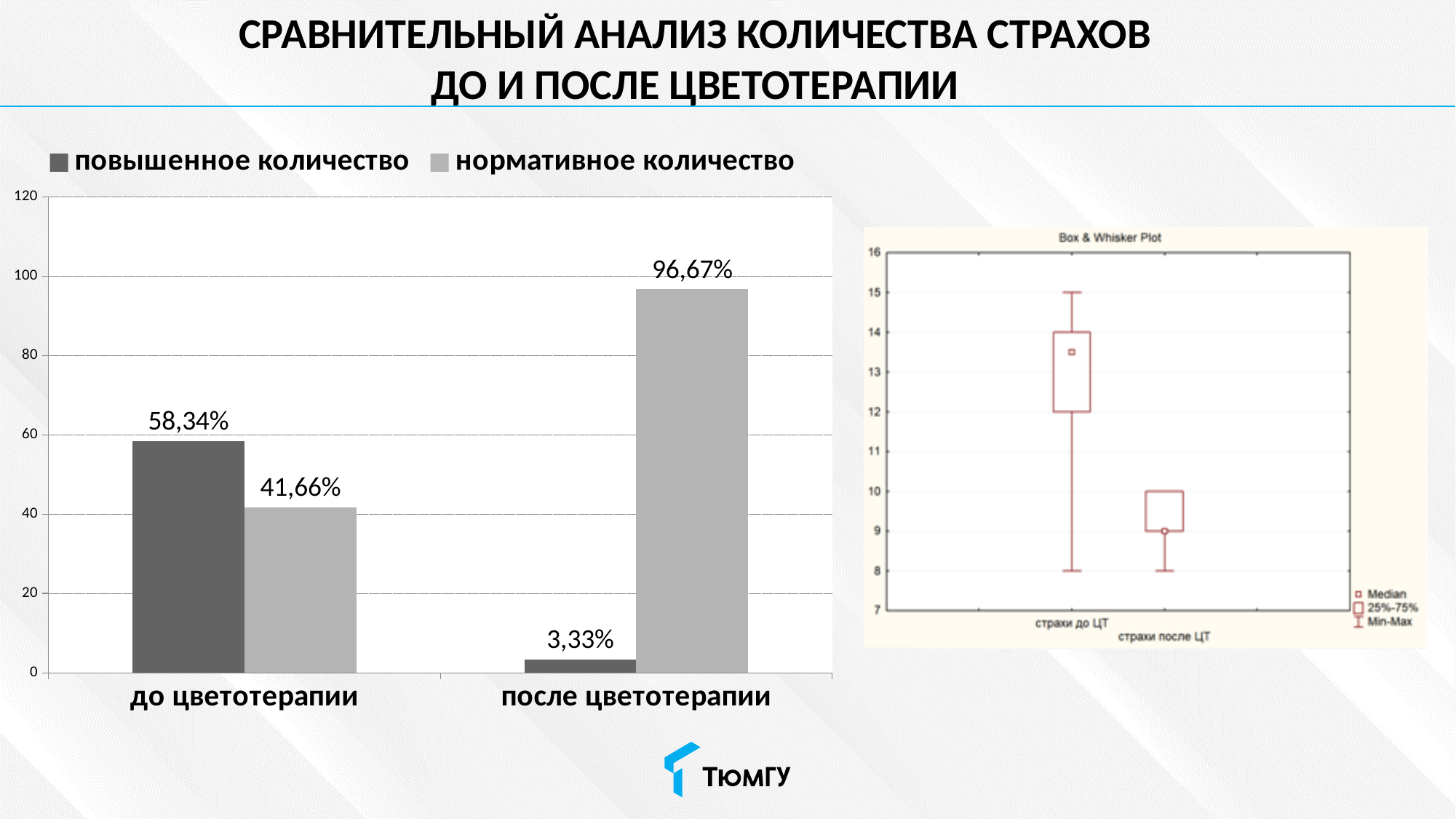
On the Box & Whisker Plot on the right, is the median for страхи после ЦТ greater or less than 10? less On the bar chart on the left, which is larger in the category до цветотерапии: повышенное количество or нормативное количество? повышенное количество On the bar chart on the left, how many series does the legend list? 2 On the Box & Whisker Plot on the right, is the median for страхи до ЦТ greater or less than 12? greater On the bar chart on the left, what is the value for повышенное количество in the category после цветотерапии? 3,33% On the bar chart on the left, which bar has the lowest value? повышенное количество, после цветотерапии On the bar chart on the left, what is the value for нормативное количество in the category до цветотерапии? 41,66% What kind of chart is the chart on the left of the slide? bar chart On the bar chart on the left, what is the value for повышенное количество in the category до цветотерапии? 58,34% On the bar chart on the left, what is the value for нормативное количество in the category после цветотерапии? 96,67% On the bar chart on the left, what is the difference between the two values in the category до цветотерапии? 16,68% On the bar chart on the left, which bar has the highest value? нормативное количество, после цветотерапии